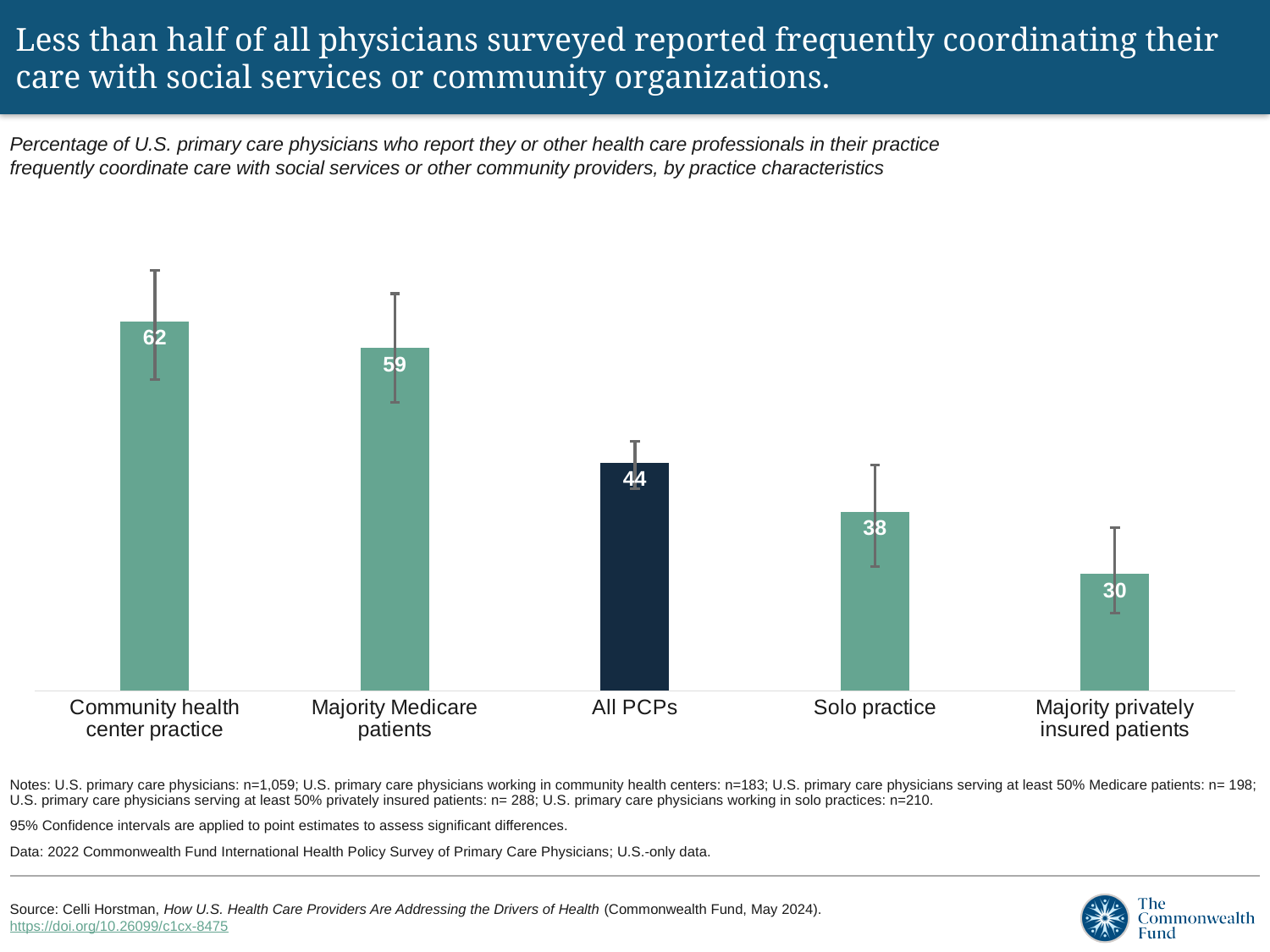
Which category has the highest value? Community health center practice How many categories are shown in the chart? 5 What is the difference between the values for All PCPs and Solo practice? 6 Which category has the lowest value? Majority privately insured patients What is the value for Solo practice? 38 What is the value for Community health center practice? 62 Which is larger, the value for Majority Medicare patients or the value for Solo practice? Majority Medicare patients What kind of chart is shown on the slide? Bar chart What is the value for Majority Medicare patients? 59 What is the difference between the values for Community health center practice and Majority privately insured patients? 32 What is the value for All PCPs? 44 What is the value for Majority privately insured patients? 30